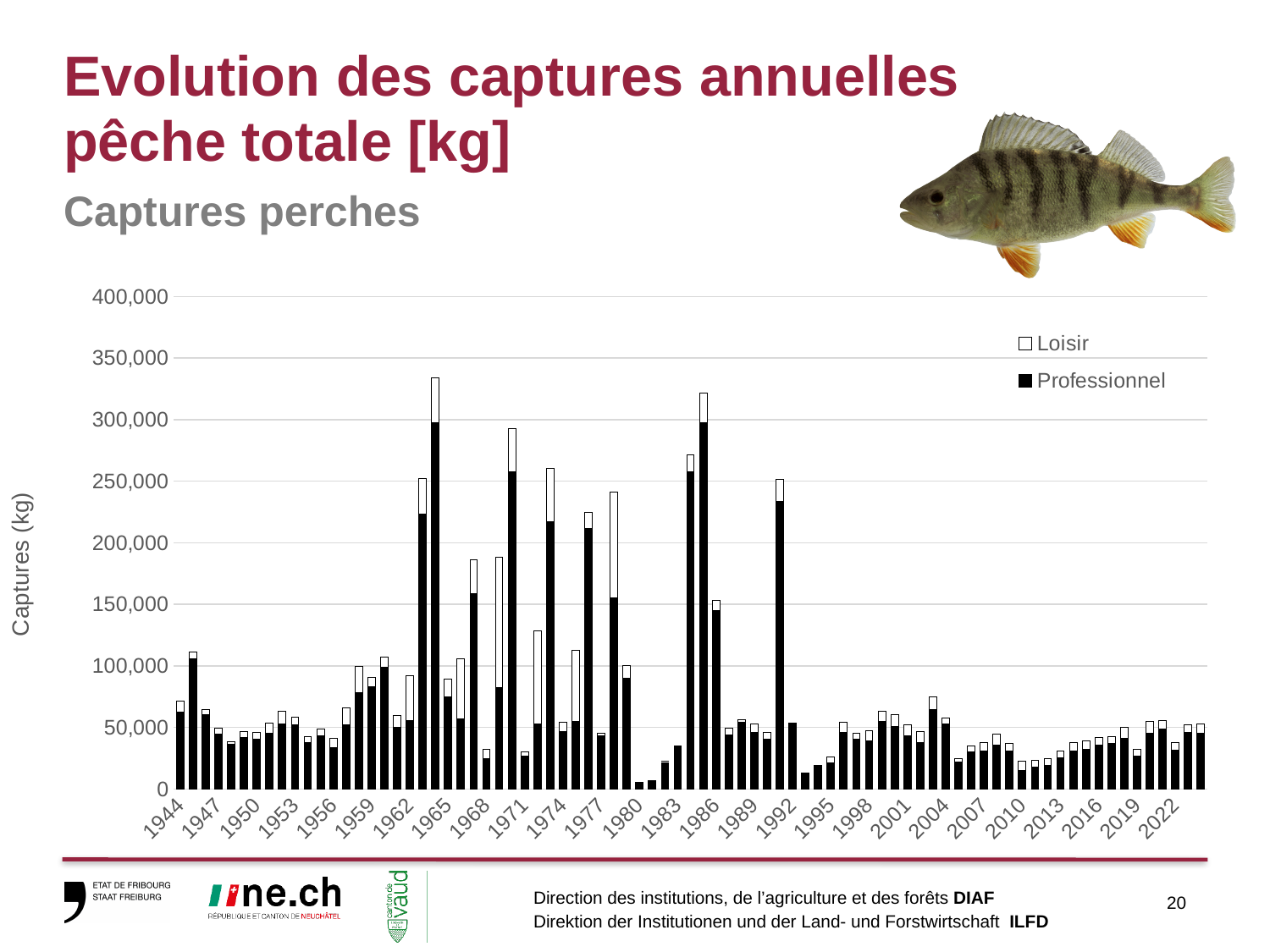
Is the total catch for 1980 greater or less than 50,000? less What are the two series named in the chart legend? Loisir and Professionnel Is the total catch for 1964 greater or less than 300,000? greater Is the total catch for 1970 greater or less than 250,000? greater Which year has the larger total catch, 1964 or 1980? 1964 What is the label on the vertical axis of the chart? Captures (kg) What kind of chart is shown on the slide? Stacked bar chart Which year has the larger total catch, 1985 or 2004? 1985 How many series does the chart legend list? 2 Which year has the larger total catch, 1991 or 1995? 1991